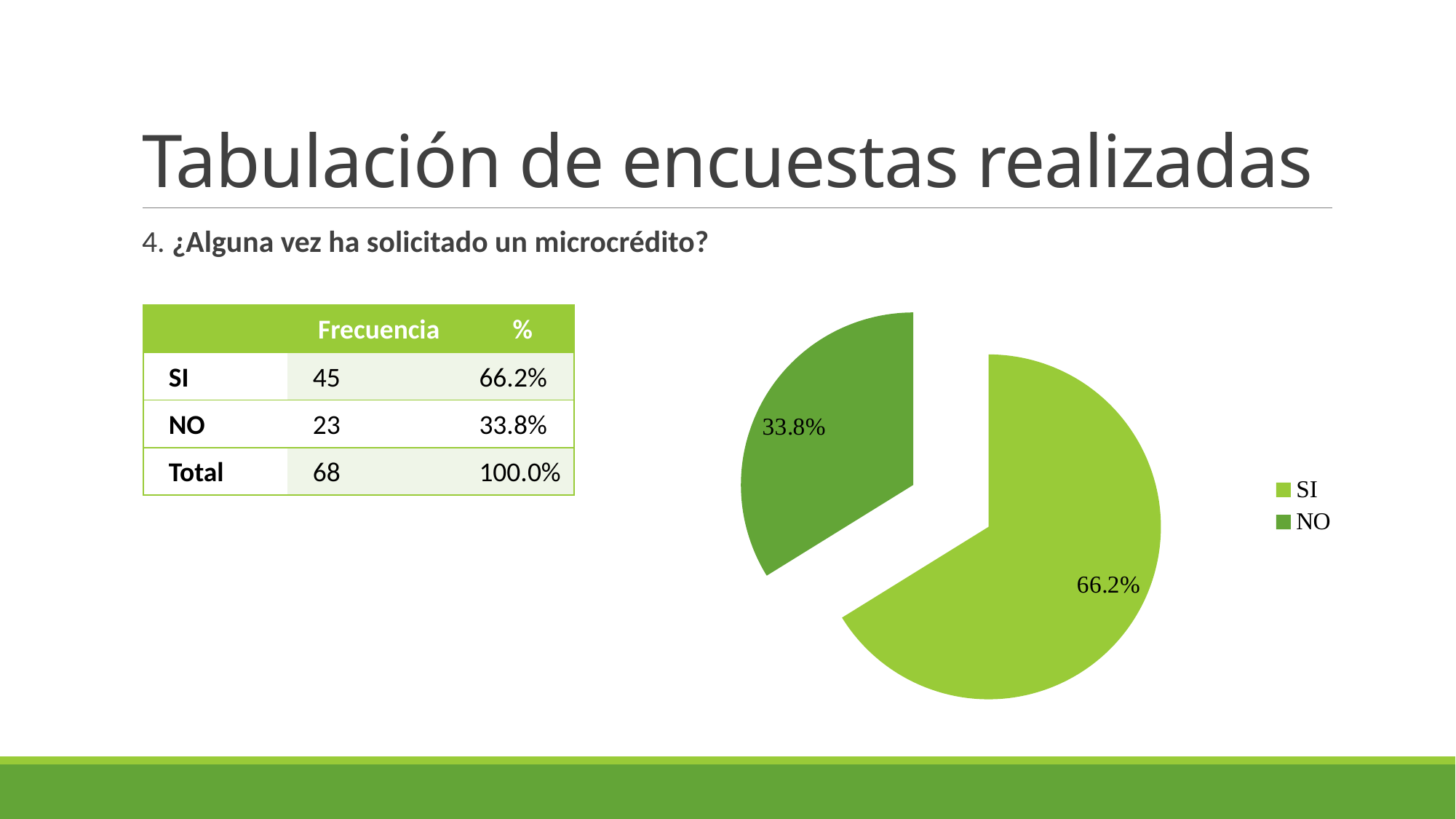
What share of the pie does the SI slice represent? 66.2% Which is larger in the pie chart, SI or NO? SI Which slice of the pie chart is the largest? SI What kind of chart is shown on the slide? pie chart What share of the pie does the NO slice represent? 33.8% Which legend entry is shown in the darker green colour? NO How many slices does the pie chart have? 2 What is the difference in percentage points between the SI and NO slices? 32.4 Is the share for SI greater or less than 50%? greater How many entries does the legend of the pie chart list? 2 Which slice of the pie chart is the smallest? NO